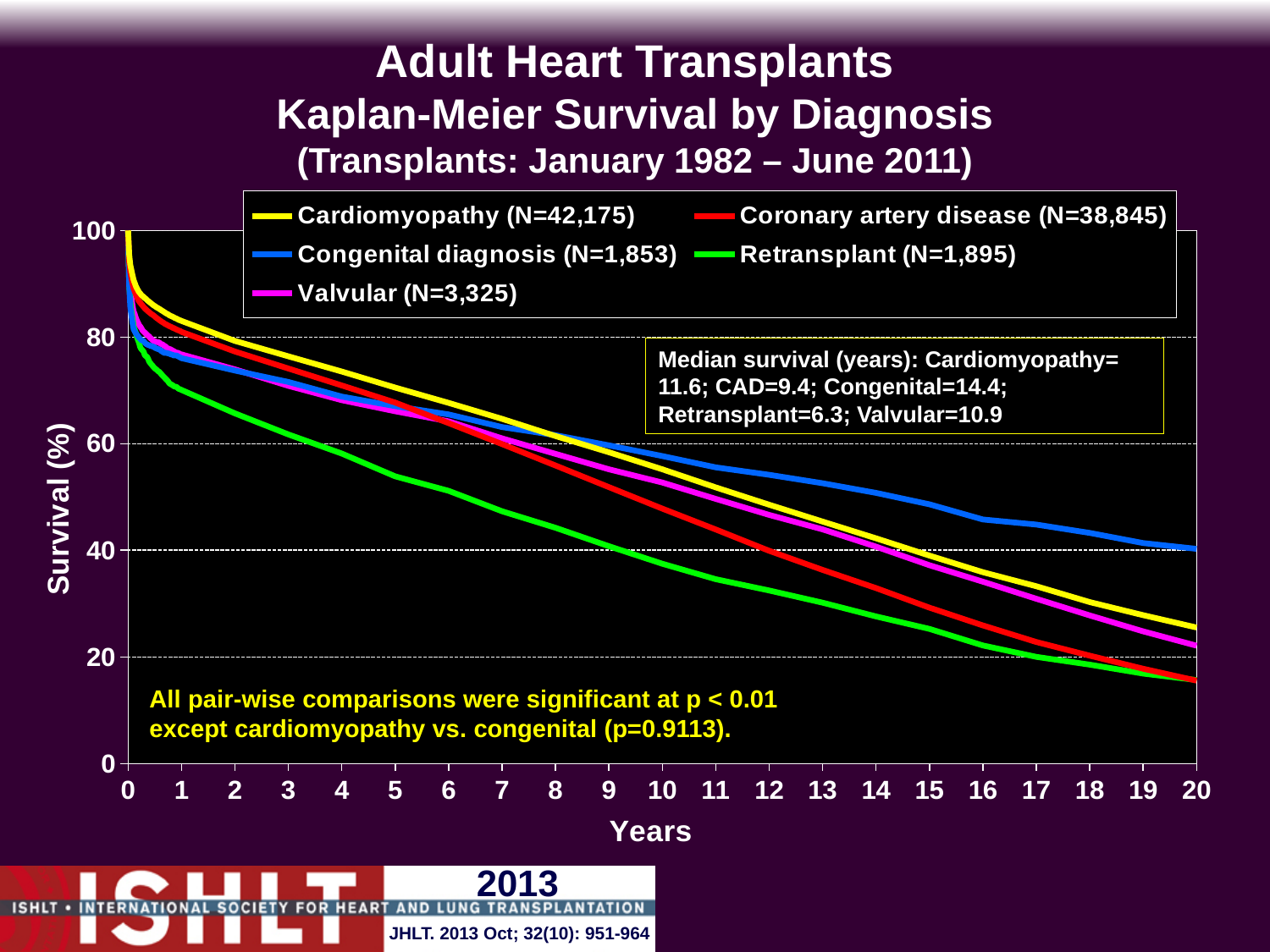
What is the median survival in years for the Valvular group? 10.9 Is the survival for the Retransplant group at 10 years greater or less than 40%? less What kind of chart is shown on the slide? Line chart Which diagnosis group has the highest median survival? Congenital Which diagnosis group has the lowest median survival? Retransplant How many series does the legend list? 5 What is the median survival in years for the Congenital diagnosis group? 14.4 Do the survival curves rise or fall as years since transplant increase? Fall What is the difference in median survival (years) between the Congenital and Retransplant groups? 8.1 How many patients (N) are in the Cardiomyopathy group according to the legend? 42,175 At 20 years, which curve is higher: Congenital diagnosis or Cardiomyopathy? Congenital diagnosis What is the median survival in years for the Retransplant group? 6.3